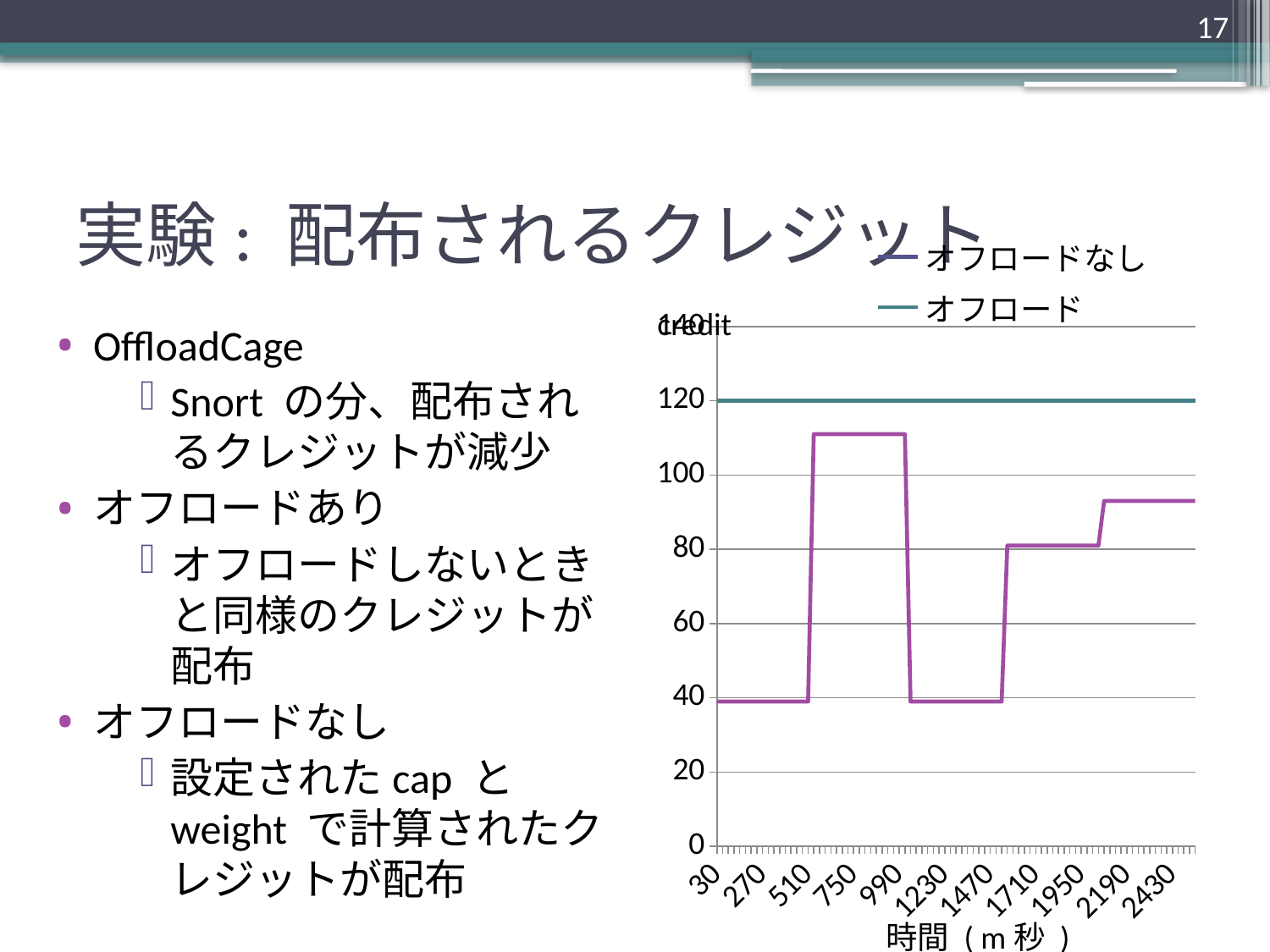
What is the label on the chart's x axis? 時間（m秒） Does the オフロード series rise, fall, or stay constant along the x axis? stays constant Is the value of the オフロード series greater or less than 100? greater What are the two series names listed in the chart's legend? オフロードなし and オフロード What kind of chart is shown on the slide? line chart How many series does the chart's legend list? 2 How many tick labels are shown on the chart's x axis? 11